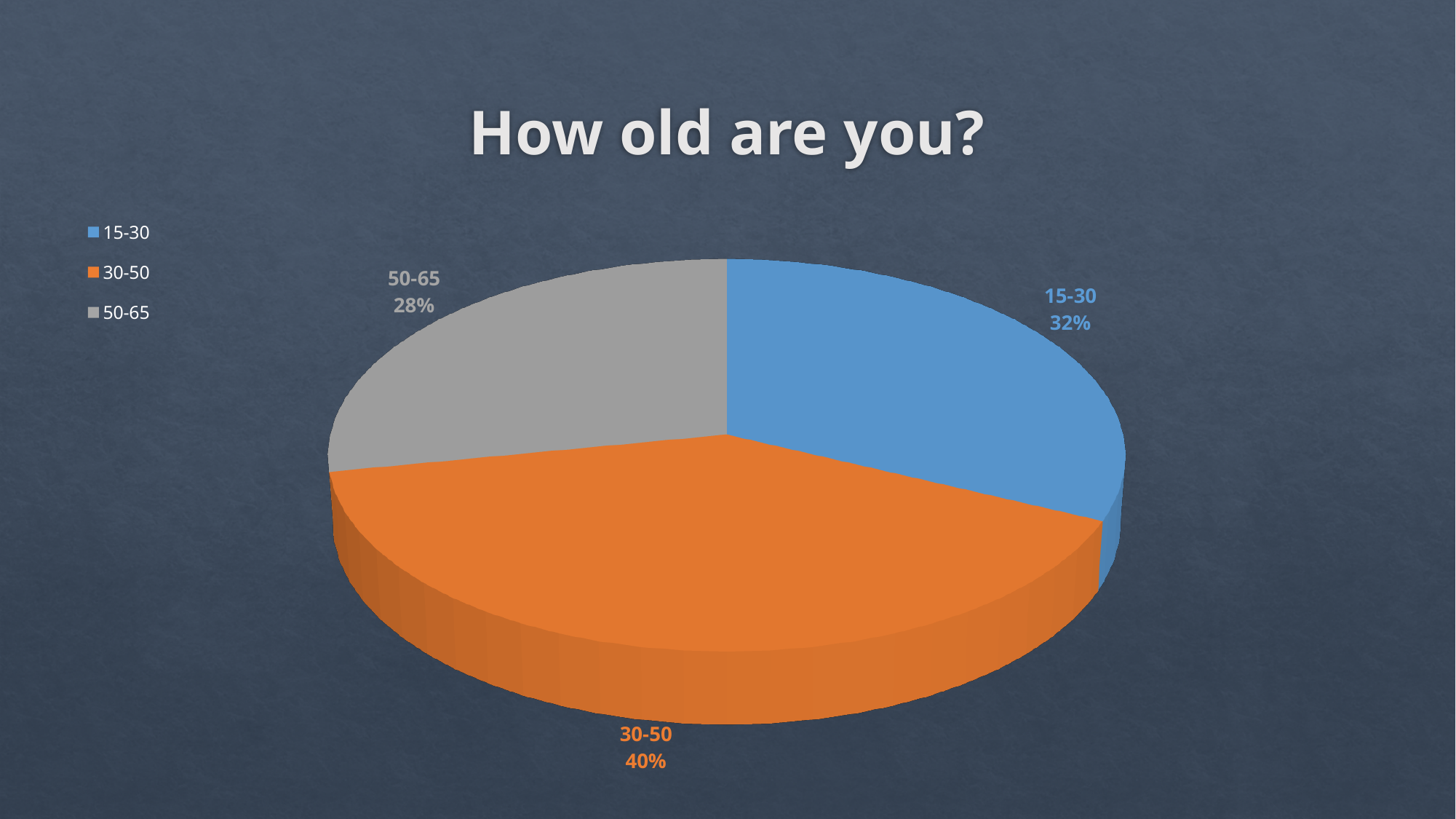
Which slice is larger, 15-30 or 50-65? 15-30 What colour is the slice for the 50-65 age group? Grey What percentage is shown for the 15-30 slice? 32% What is the difference in percentage points between the 15-30 slice and the 50-65 slice? 4 How many age groups are shown in the pie chart? 3 Which age group has the largest slice of the pie? 30-50 What is the difference in percentage points between the 30-50 slice and the 50-65 slice? 12 Which age group has the smallest slice of the pie? 50-65 What kind of chart is shown on the slide? Pie chart What is the title of the chart? How old are you? What share of the pie does the 30-50 age group have? 40% What percentage is shown for the 50-65 slice? 28%